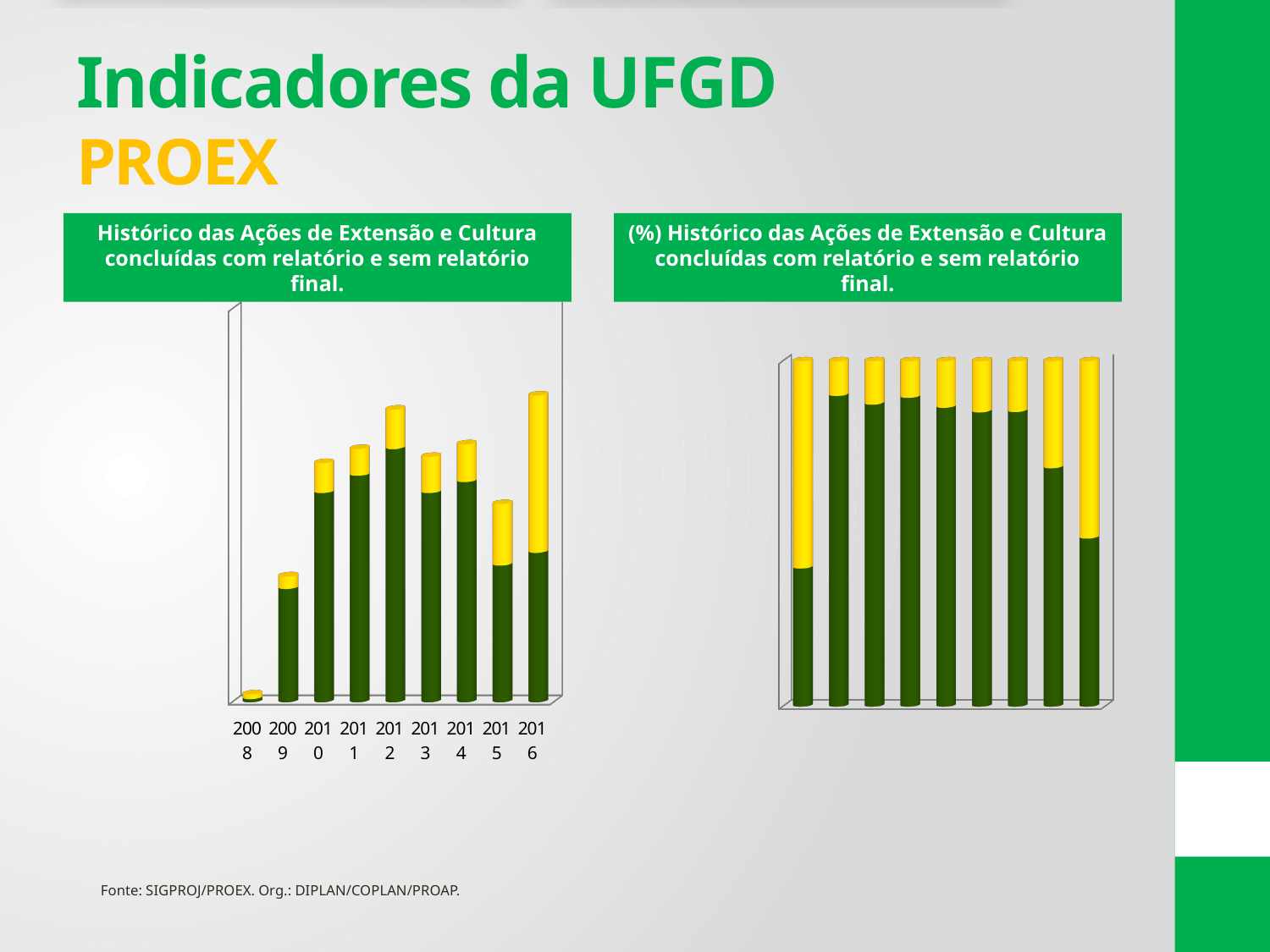
In the left chart, which year has the tallest total bar? 2016 In the left chart, which year has the shortest total bar? 2008 In the left chart, which year has the tallest green segment? 2012 In the left chart, which year has the tallest yellow segment? 2016 What kind of chart is the left chart, titled 'Histórico das Ações de Extensão e Cultura concluídas com relatório e sem relatório final.'? Stacked bar chart What two colours are used for the segments in the charts? Green and yellow In the right chart, how many bars are plotted? 9 What kind of chart is the right chart, titled '(%) Histórico das Ações de Extensão e Cultura concluídas com relatório e sem relatório final.'? 100% stacked bar chart In the left chart, how many years are shown on the x axis? 9 In the left chart, is the green segment for 2015 taller or shorter than the green segment for 2014? Shorter In the left chart, what is the first year shown on the x axis? 2008 In the left chart, is the total bar for 2012 taller or shorter than the total bar for 2009? Taller